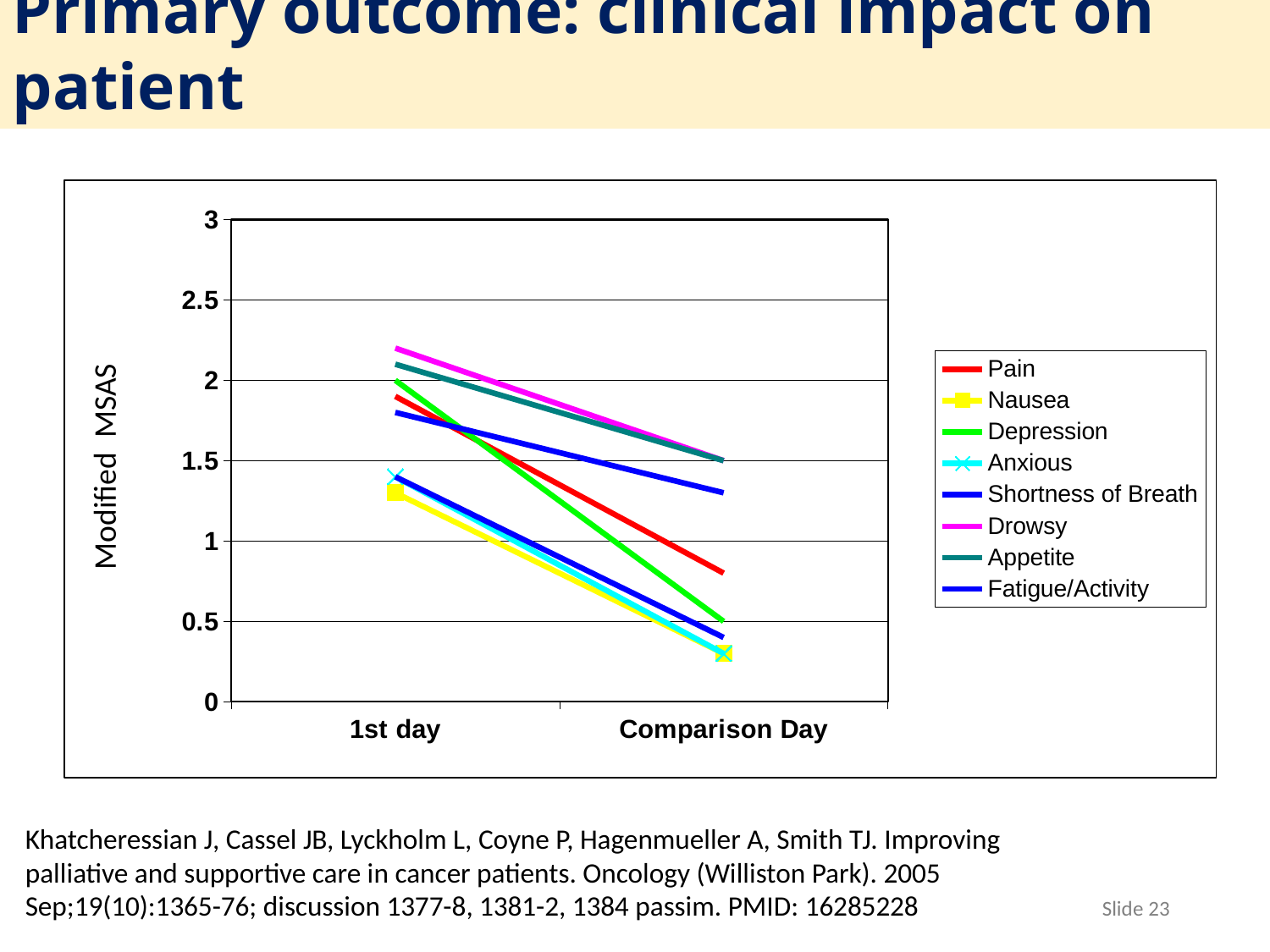
How many categories are shown on the x axis? 2 Is the value for Pain on the Comparison Day greater or less than 1? less Is the value for Fatigue/Activity on the 1st day greater or less than 2? less Is the value for Nausea on the Comparison Day greater or less than 0.5? less Which series has the highest value on the 1st day? Drowsy What colour is the Pain line in the legend? red What is the title of the y axis? Modified MSAS On the Comparison Day, which is larger: Pain or Fatigue/Activity? Fatigue/Activity What kind of chart is shown on the slide? line chart How many series does the legend list? 8 Does the Pain line rise or fall from 1st day to Comparison Day? fall